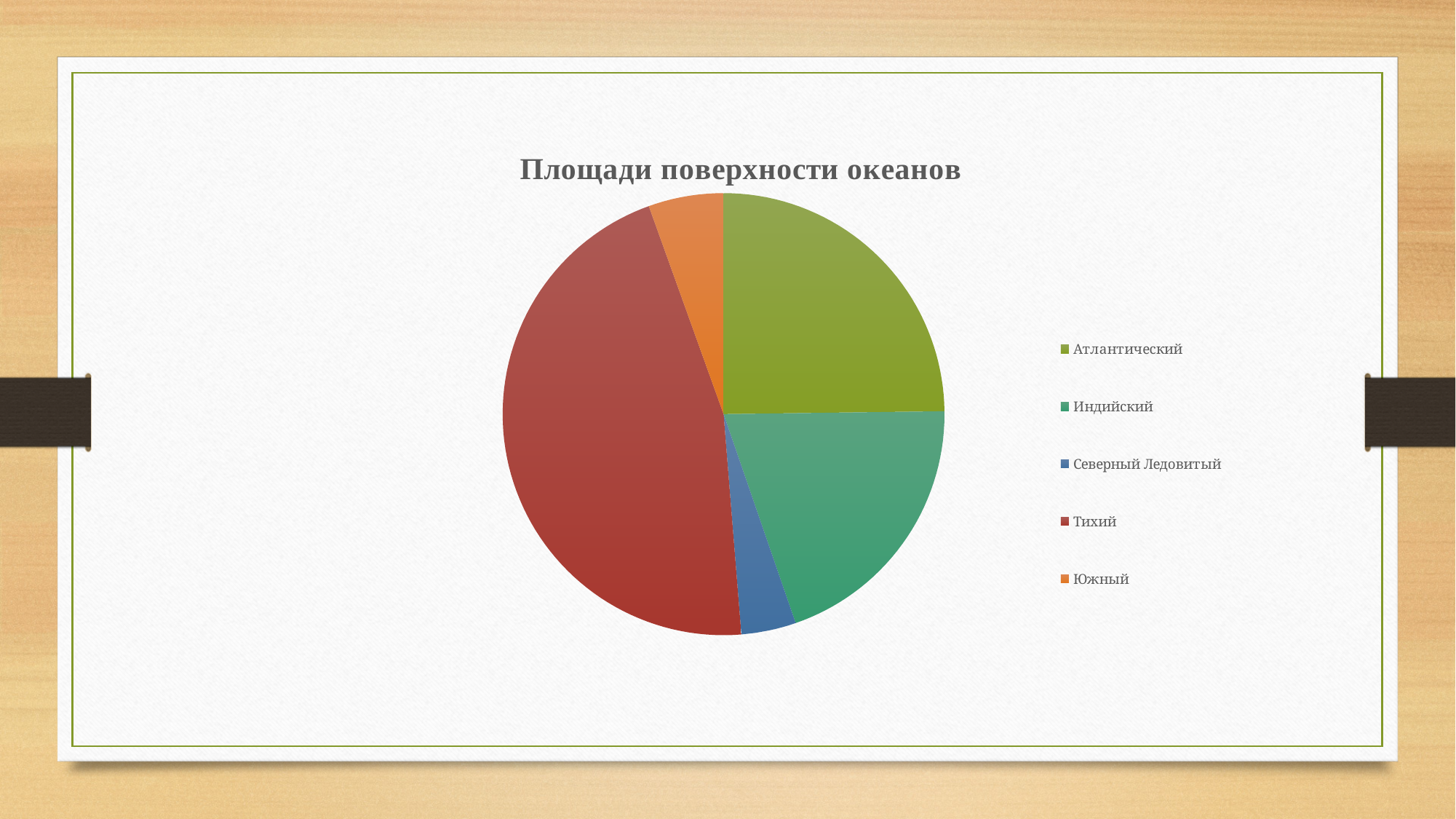
Which legend entry is shown in red? Тихий How many entries does the legend list? 5 What kind of chart is shown on the slide? pie chart Which slice is larger, Индийский or Южный? Индийский What is the title of the chart? Площади поверхности океанов Which ocean has the largest slice of the pie? Тихий How many slices does the pie chart have? 5 Which slice is larger, Атлантический or Индийский? Атлантический Which slice is larger, Тихий or Северный Ледовитый? Тихий